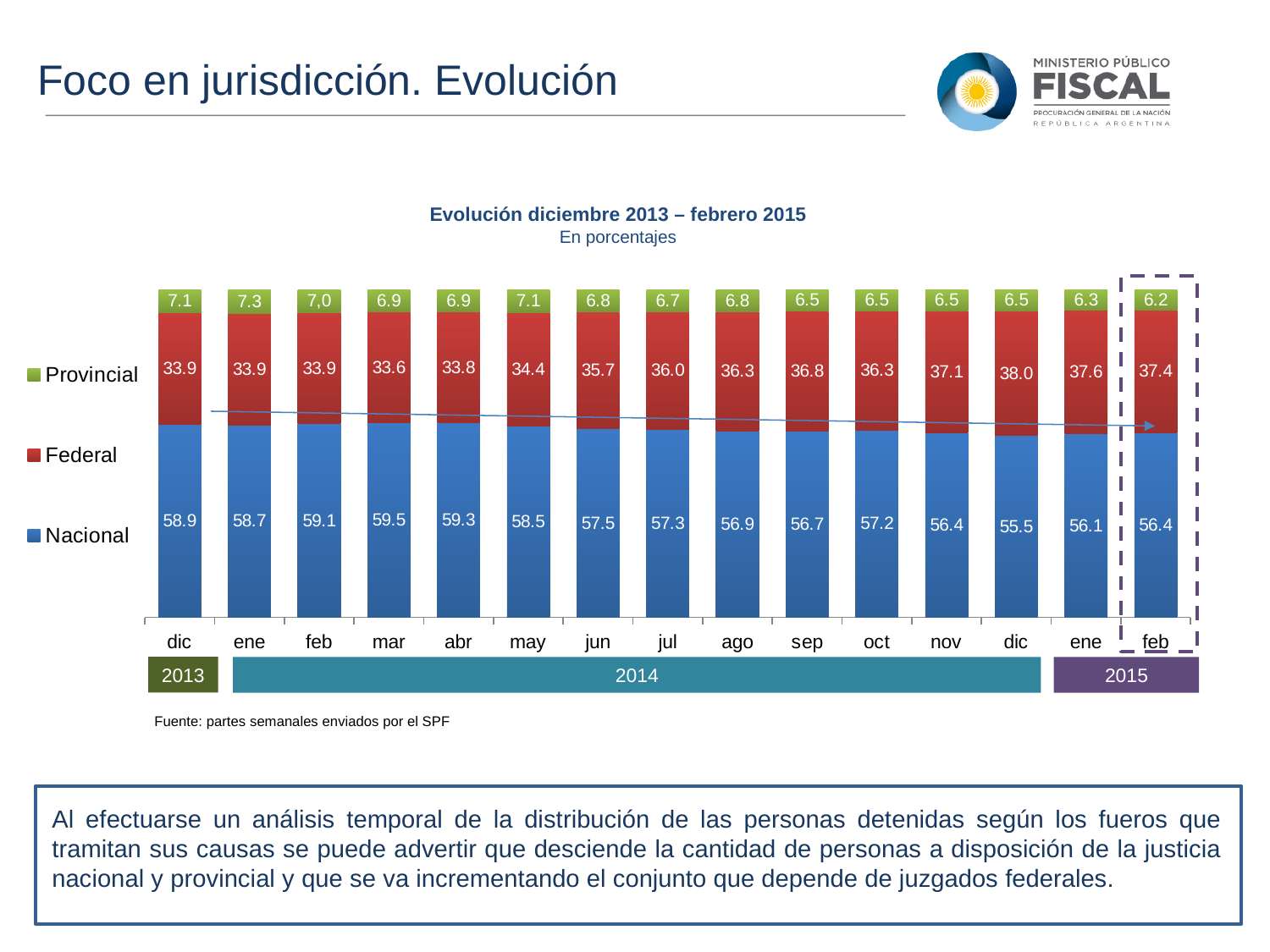
What is the difference between the Nacional value for mar 2014 and the Nacional value for dic 2014? 4.0 What is the title of the chart? Evolución diciembre 2013 – febrero 2015 Does the Federal value generally rise or fall from dic 2013 to feb 2015? Rise How many months are shown on the x axis? 15 What is the Federal value for dic 2014? 38.0 What is the Provincial value for ene 2014? 7.3 Which is larger, the Federal value for dic 2013 or the Federal value for feb 2015? feb 2015 What is the Nacional value for feb 2015? 56.4 How many series does the legend list? 3 In which month is the Federal value highest? dic 2014 In which month is the Nacional value lowest? dic 2014 What kind of chart is shown on the slide? Stacked bar chart